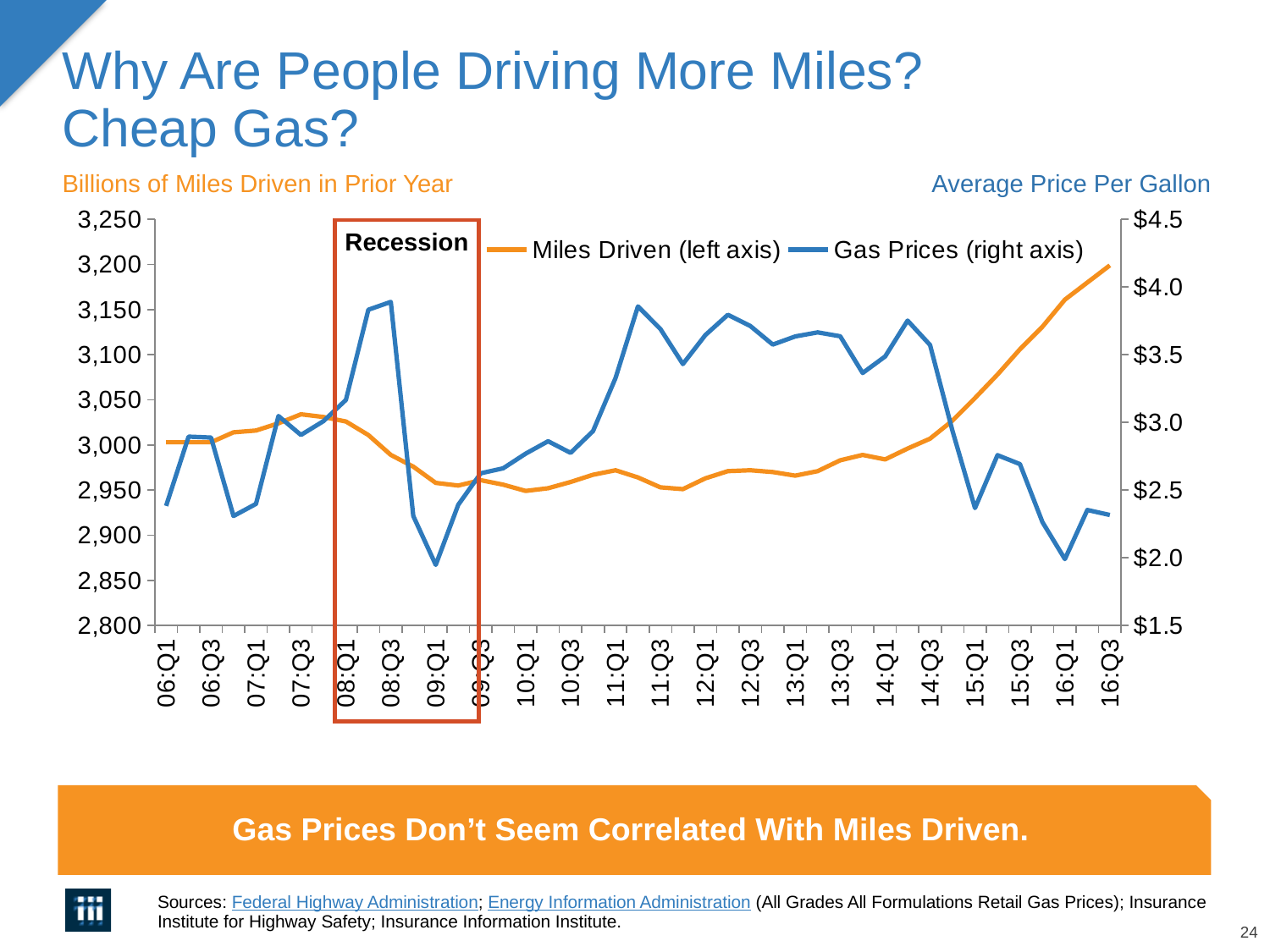
At which quarter is the Miles Driven series highest? 16:Q3 How many series does the chart's legend list? 2 Is the Gas Prices value for 09:Q1 greater or less than $2.5? less Is the Miles Driven value for 10:Q1 greater or less than 3,000? less What kind of chart is shown on the slide? Line chart Is the Gas Prices value for 08:Q3 greater or less than $3.5? greater Which series is plotted against the right axis? Gas Prices Which is larger, the Gas Prices value at 08:Q3 or at 09:Q1? 08:Q3 What period is marked by the red box on the chart? Recession Does the Miles Driven series rise or fall from 14:Q3 to 16:Q3? rise